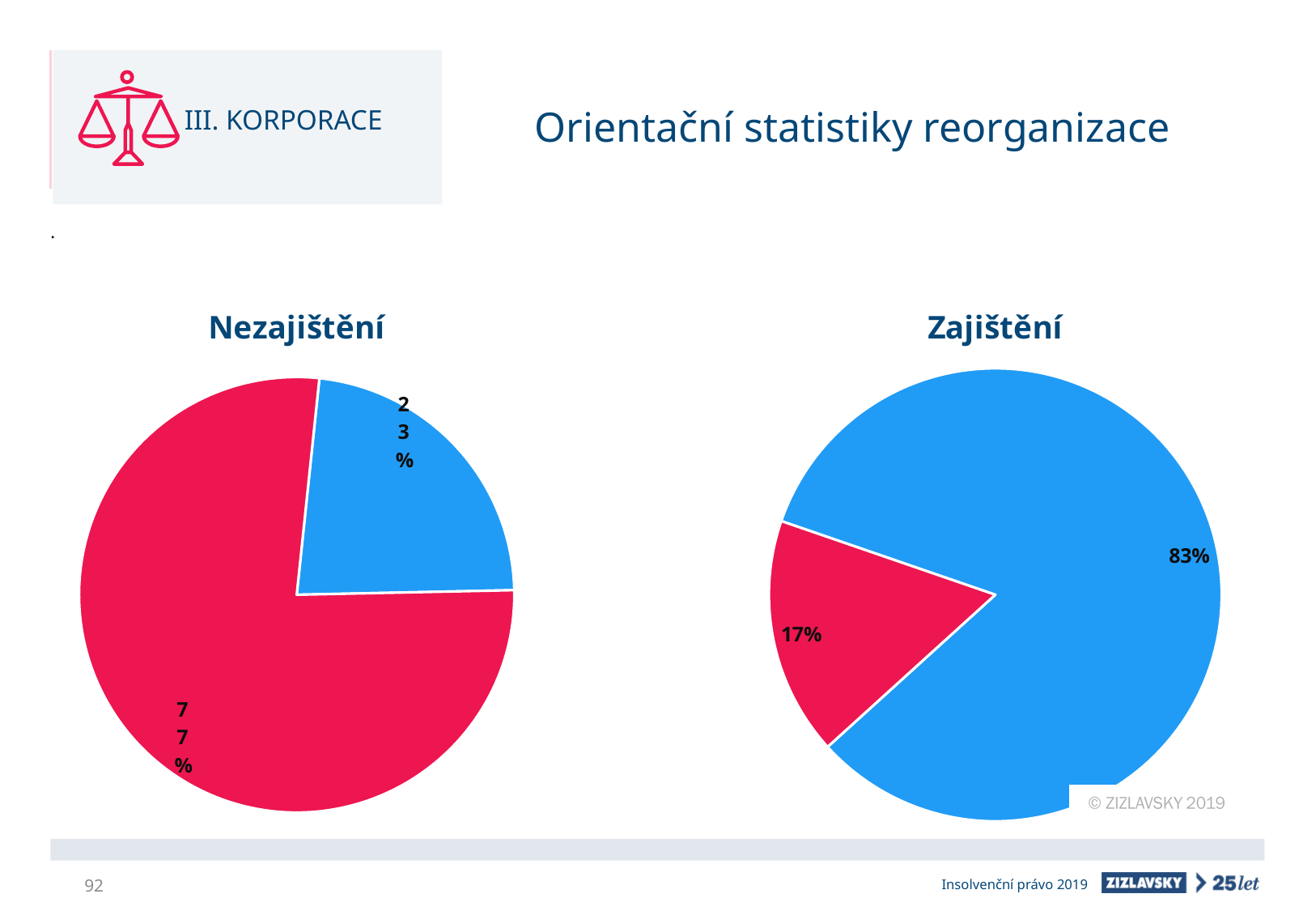
In the "Zajištění" chart, what share does the red slice represent? 17% In the "Zajištění" chart, which slice is the smallest? the red slice (17%) In the "Nezajištění" chart, what share does the blue slice represent? 23% In the "Zajištění" chart, what is the difference between the blue slice and the red slice? 66 percentage points How many pie charts are shown on the slide? 2 How many slices does the "Zajištění" pie chart have? 2 In the "Nezajištění" chart, which slice is larger, the red one or the blue one? the red one What is the title of the pie chart on the right side of the slide? Zajištění In the "Zajištění" chart, what share does the blue slice represent? 83% In the "Nezajištění" chart, what is the difference between the red slice and the blue slice? 54 percentage points What type of chart is the "Nezajištění" chart? pie chart